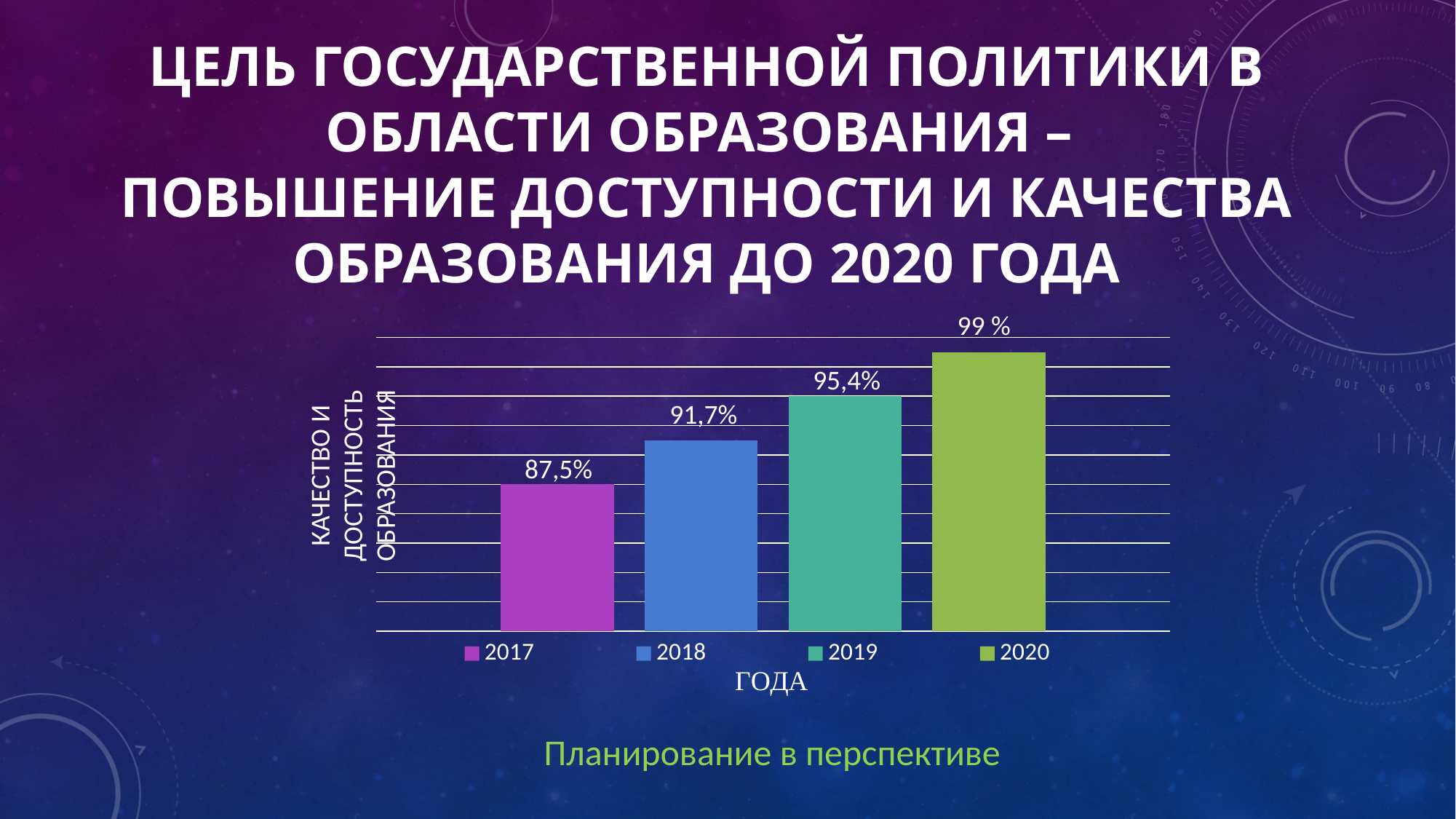
What is the value shown for 2018? 91,7% Which is larger, the value for 2018 or the value for 2019? 2019 Which year has the lowest value? 2017 What is the value shown for 2019? 95,4% Do the values rise or fall from 2017 to 2020? Rise How many bars are plotted in the chart? 4 What kind of chart is shown on the slide? Bar chart What is the difference between the values for 2019 and 2018? 3,7% What is the difference between the values for 2020 and 2017? 11,5% Which year has the highest value? 2020 What is the value shown for 2017? 87,5% What is the value shown for 2020? 99 %